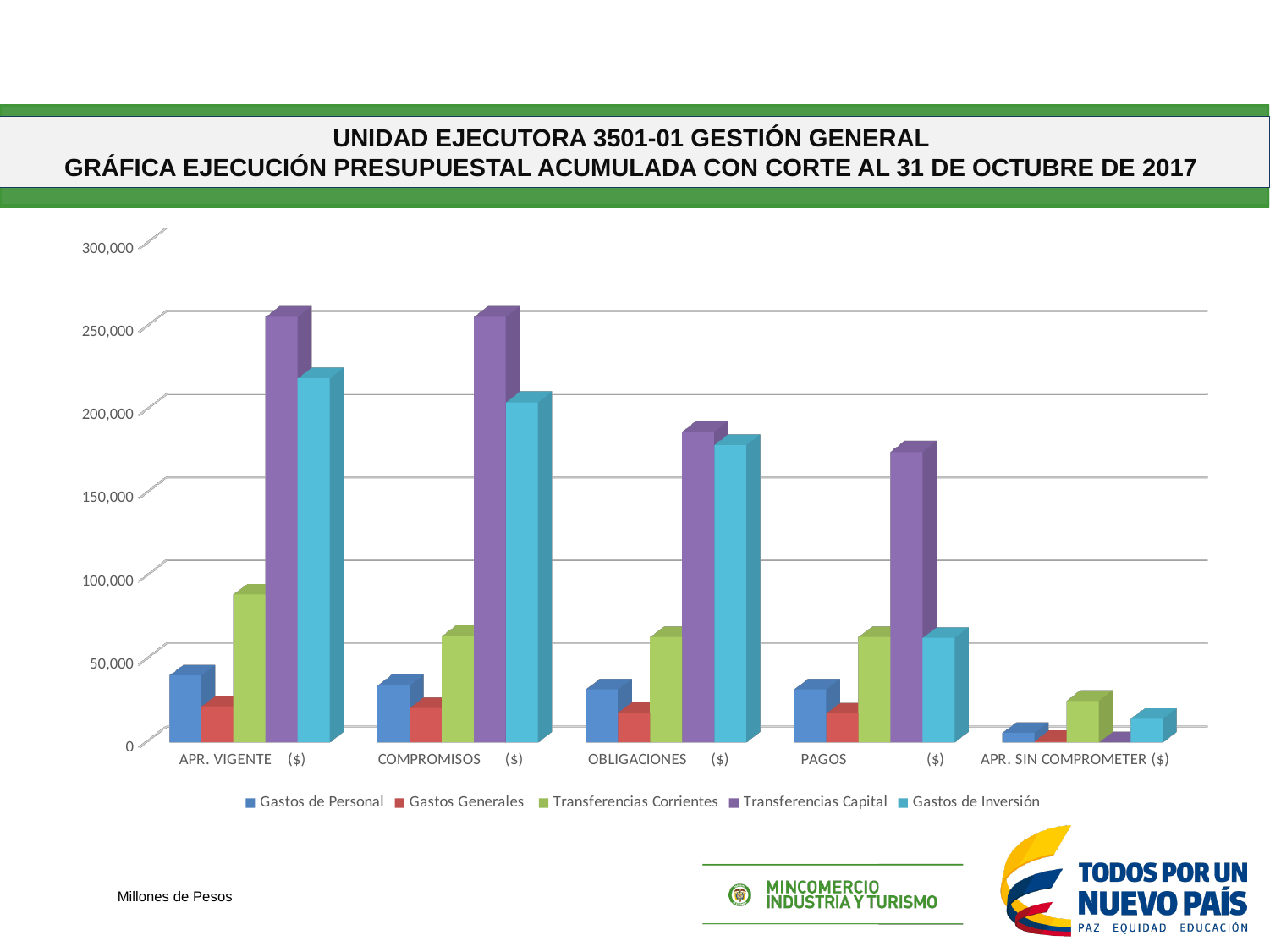
Is the value for Gastos de Inversión in OBLIGACIONES greater or less than 150,000? greater In the PAGOS category, which is larger: Transferencias Capital or Gastos de Inversión? Transferencias Capital What kind of chart is shown on the slide? Bar chart In the APR. SIN COMPROMETER category, which series has the highest value? Transferencias Corrientes What unit is stated below the chart for the values? Millones de Pesos Is the value for Transferencias Corrientes in APR. VIGENTE greater or less than 50,000? greater Is the value for Gastos de Personal in APR. VIGENTE greater or less than 50,000? less How many series does the legend list? 5 How many categories are shown along the x axis? 5 In the APR. VIGENTE category, which series has the highest value? Transferencias Capital Do the values for Transferencias Capital rise or fall from APR. VIGENTE to APR. SIN COMPROMETER? fall